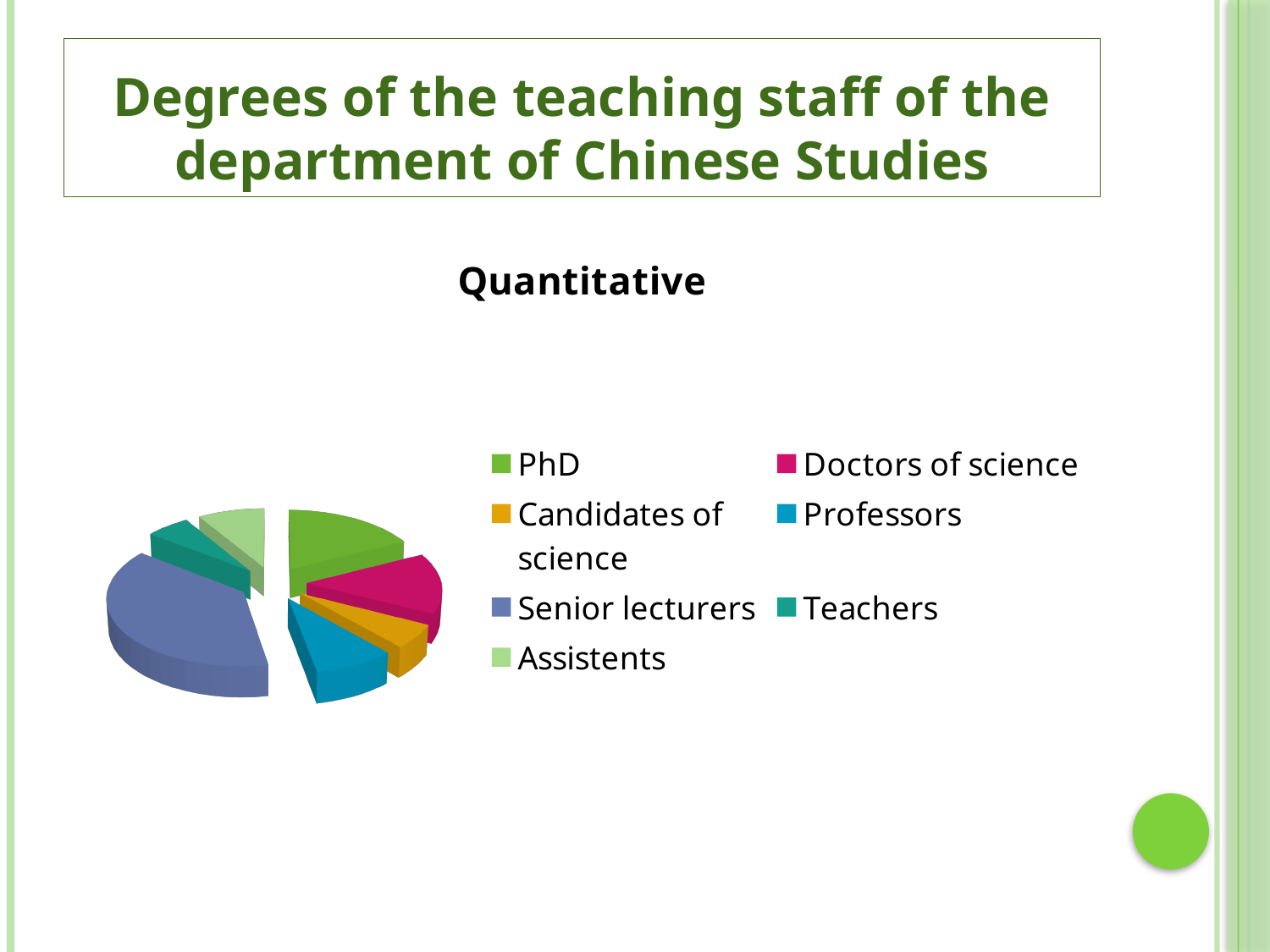
Which slice is larger, Doctors of science or Assistents? Doctors of science How many categories does the pie chart's legend list? 7 What kind of chart is shown on the slide? pie chart Which slice is larger, Senior lecturers or Doctors of science? Senior lecturers Which slice is larger, Senior lecturers or PhD? Senior lecturers Which category has the largest slice of the pie chart? Senior lecturers Which category is shown in pink/magenta in the pie chart? Doctors of science What is the title of the slide containing the pie chart? Degrees of the teaching staff of the department of Chinese Studies